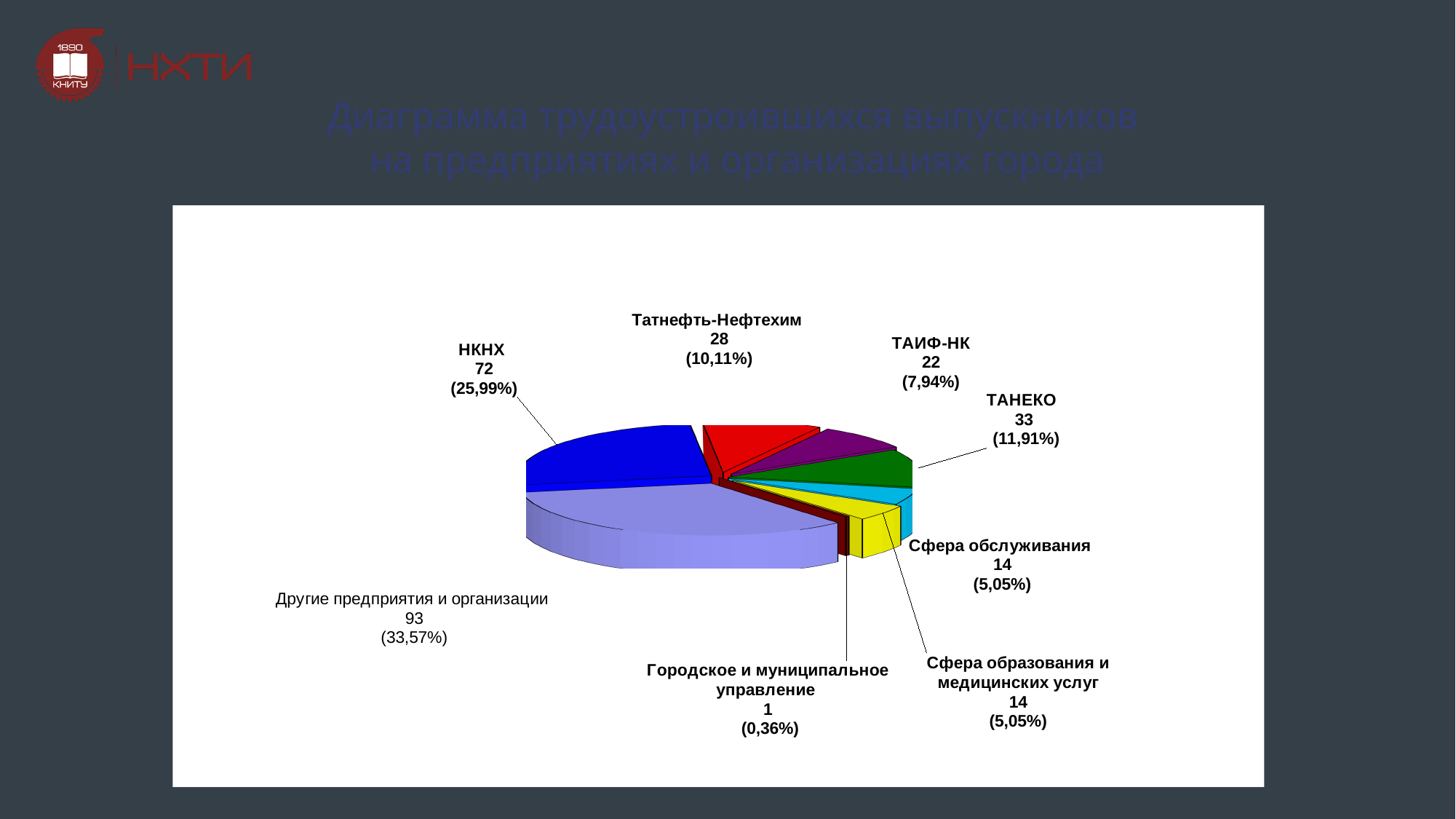
How many graduates were employed at НКНХ? 72 What share of the pie does ТАНЕКО represent? 11,91% Which category has the largest slice of the pie? Другие предприятия и организации What is the difference between the number of graduates at НКНХ and at Татнефть-Нефтехим? 44 What colour is the slice for НКНХ? Blue Which category has the smallest slice of the pie? Городское и муниципальное управление How many graduates were employed at ТАИФ-НК? 22 What type of chart is shown on the slide? Pie chart What is the total number of graduates across all slices of the pie? 277 How many categories are shown in the pie chart? 8 What percentage is shown for Сфера обслуживания? 5,05% Which is larger: the value for ТАНЕКО or the value for Татнефть-Нефтехим? ТАНЕКО